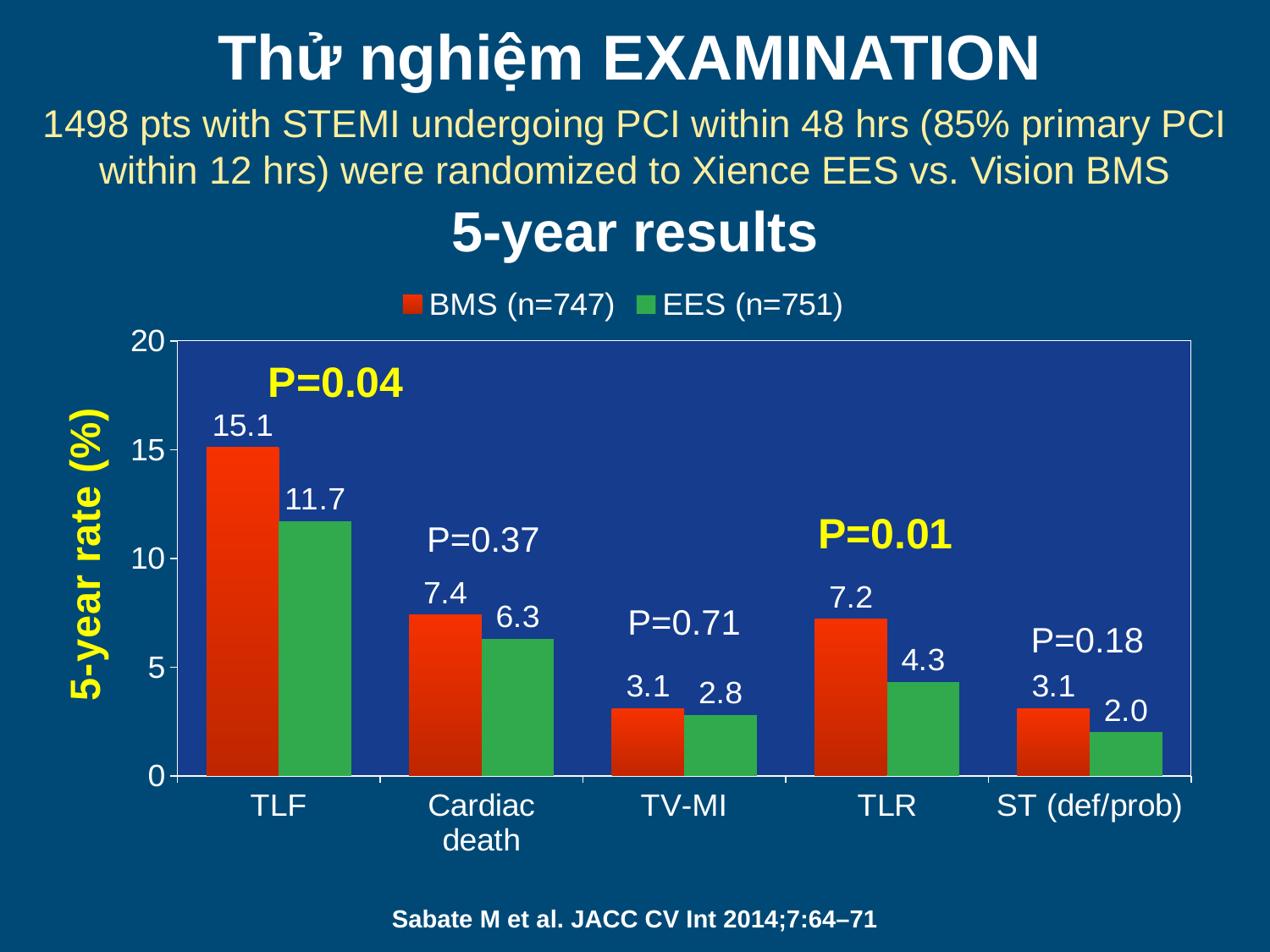
What is the 5-year rate for EES in the ST (def/prob) category? 2.0 How many series does the legend list? 2 What is the difference between the BMS and EES 5-year rates for TLF? 3.4 What is the 5-year rate for EES in the TLR category? 4.3 What is the difference between the BMS and EES 5-year rates for TLR? 2.9 What kind of chart is shown on the slide? Bar chart Which category has the highest BMS 5-year rate? TLF Is the EES 5-year rate for TLF greater or less than 10? greater How many categories are shown on the x axis? 5 What is the 5-year rate for BMS in the TLF category? 15.1 Which category has the lowest EES 5-year rate? ST (def/prob) Which is larger, the BMS rate for Cardiac death or the BMS rate for TLR? Cardiac death